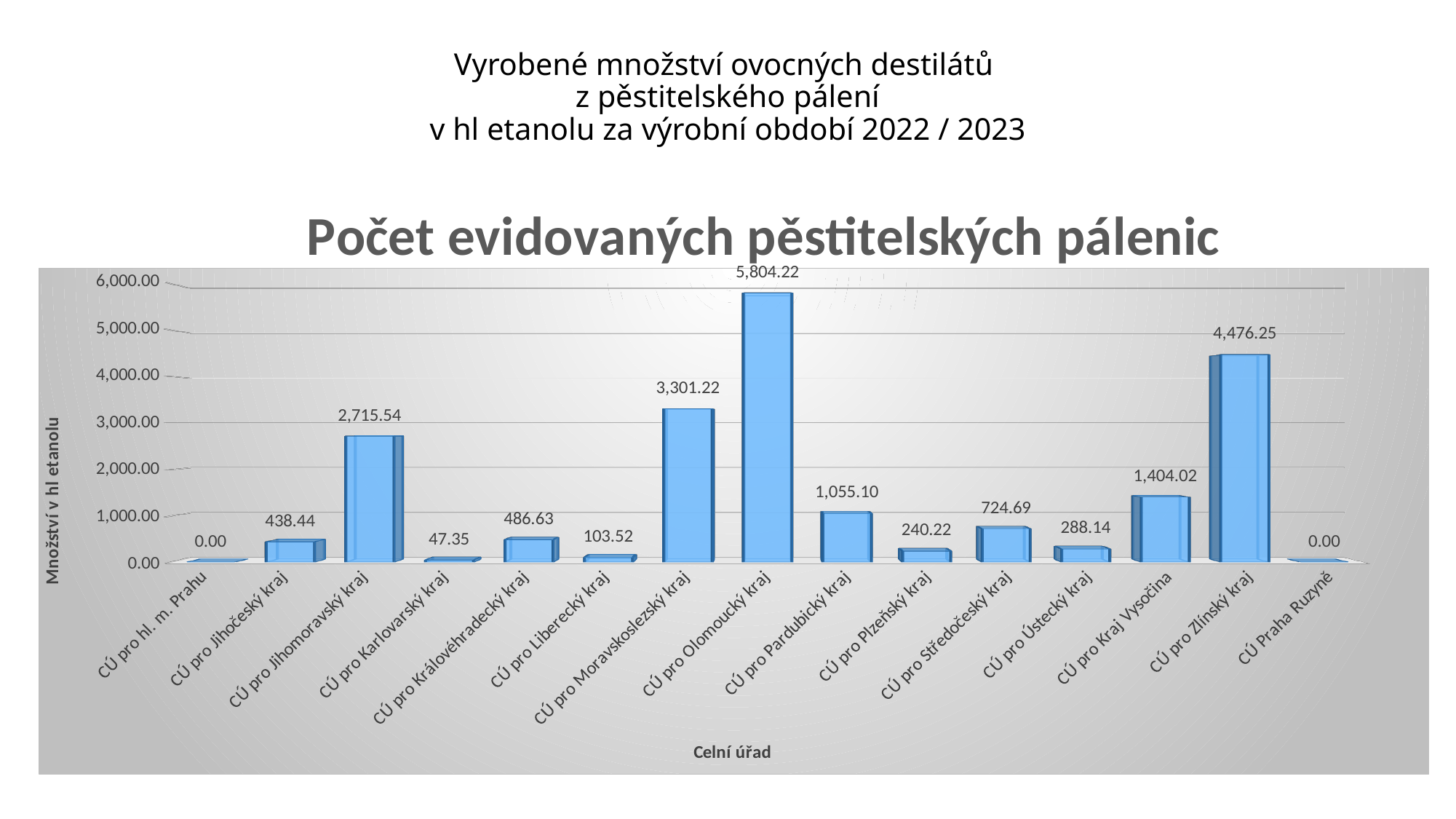
Which category has the highest value? CÚ pro Olomoucký kraj What is the value for CÚ pro Kraj Vysočina? 1,404.02 What is the difference between the values for CÚ pro Olomoucký kraj and CÚ pro Zlínský kraj? 1,327.97 Which is larger, the value for CÚ pro Kraj Vysočina or CÚ pro Pardubický kraj? CÚ pro Kraj Vysočina What is the difference between the values for CÚ pro Moravskoslezský kraj and CÚ pro Jihomoravský kraj? 585.68 What is the value for CÚ pro Karlovarský kraj? 47.35 What kind of chart is shown on the slide? bar chart How many categories are shown on the x axis? 15 Is the value for CÚ pro Středočeský kraj greater or less than 1,000.00? less What is the value for CÚ pro Olomoucký kraj? 5,804.22 What is the title of the chart? Počet evidovaných pěstitelských pálenic What is the value for CÚ pro Jihomoravský kraj? 2,715.54